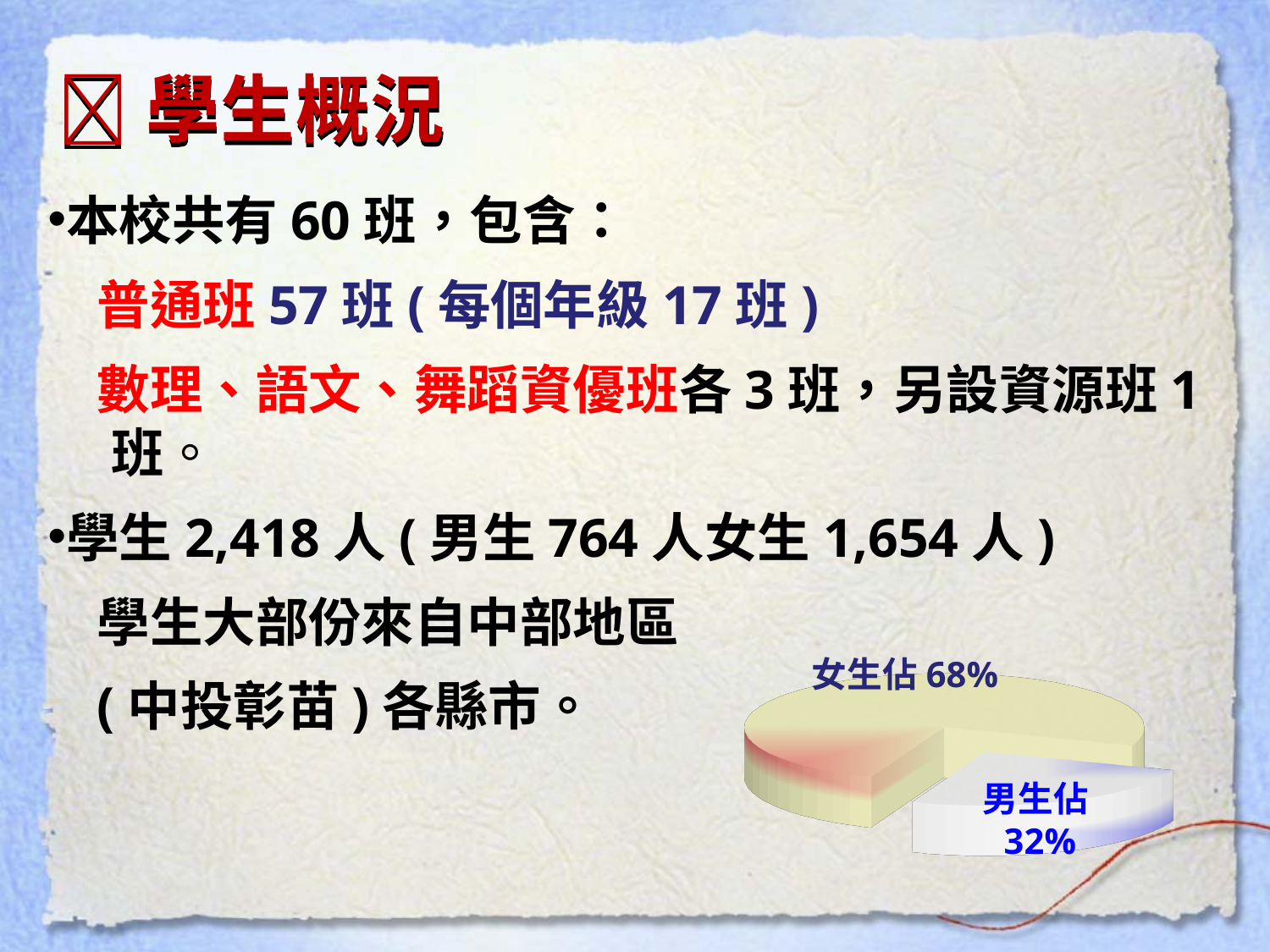
Which is larger in the pie chart, the 女生 share or the 男生 share? 女生 What kind of chart is shown on the slide? pie chart Is the 女生 share in the pie chart greater or less than 50%? greater What is the label on the pulled-out slice of the pie chart? 男生佔 32% Which slice of the pie chart is the smallest? 男生 What share of the pie chart does 男生 (male students) take? 32% How many slices does the pie chart have? 2 Is the 男生 share in the pie chart greater or less than 50%? less Which slice of the pie chart is the largest? 女生 By how many percentage points does the 女生 share exceed the 男生 share in the pie chart? 36% What share of the pie chart does 女生 (female students) take? 68%